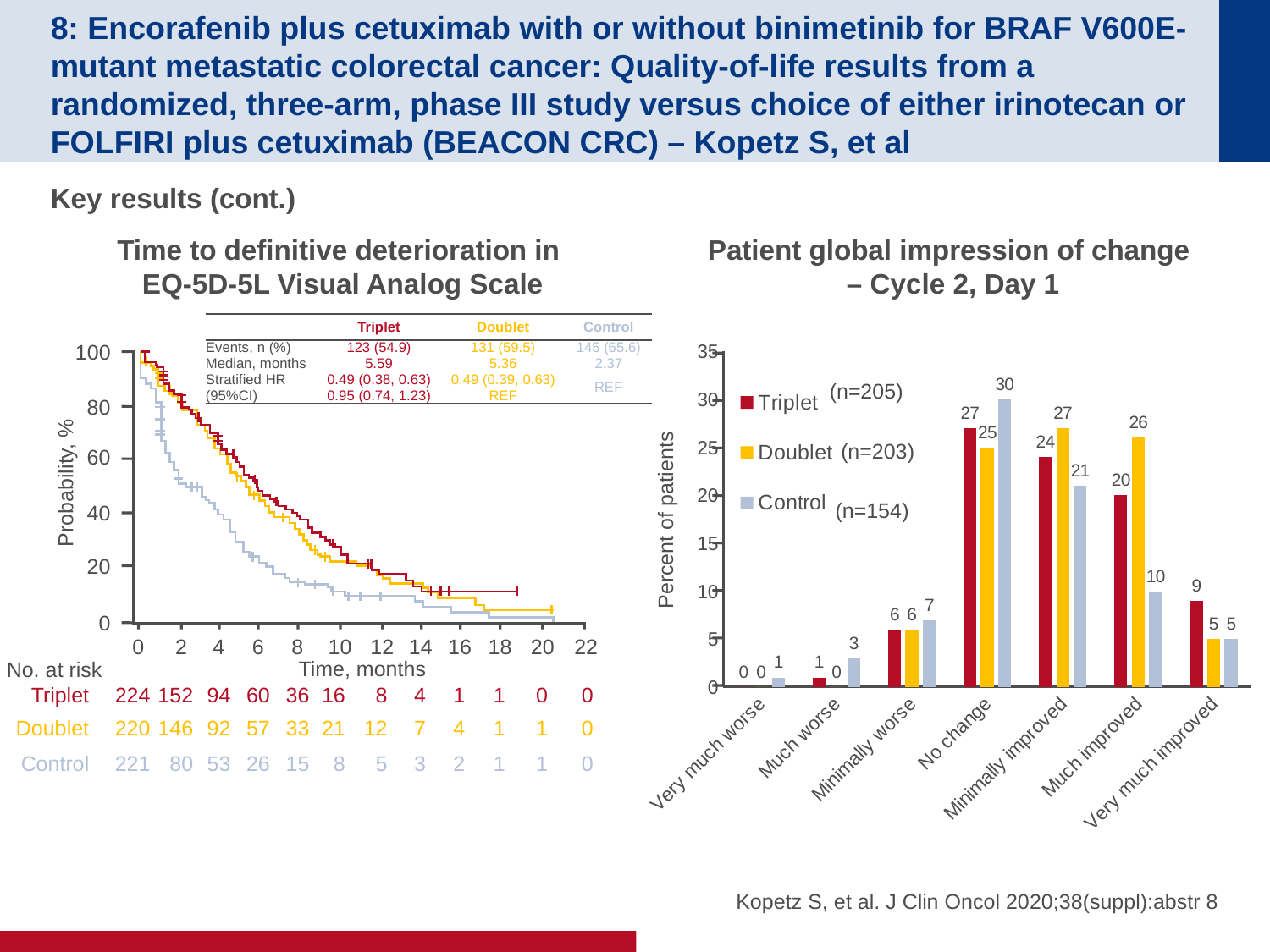
In the 'Patient global impression of change – Cycle 2, Day 1' chart, what is the difference between the Doublet and Control values in the 'Much improved' category? 16 What kind of chart is the 'Patient global impression of change – Cycle 2, Day 1' chart? Bar chart In the 'Patient global impression of change – Cycle 2, Day 1' chart, what percent of Control patients reported 'No change'? 30 In the 'Patient global impression of change – Cycle 2, Day 1' chart, how many series does the legend list? 3 In the 'Patient global impression of change – Cycle 2, Day 1' chart, what is the value for Triplet in the 'Very much improved' category? 9 In the 'Patient global impression of change – Cycle 2, Day 1' chart, which category has the lowest value for the Control series? Very much worse In the 'Patient global impression of change – Cycle 2, Day 1' chart, which category has the highest value for the Triplet series? No change In the 'Patient global impression of change – Cycle 2, Day 1' chart, which is larger in the 'Minimally improved' category: Triplet or Doublet? Doublet In the 'Patient global impression of change – Cycle 2, Day 1' chart, what is the value for Doublet in the 'Much improved' category? 26 In the 'Patient global impression of change – Cycle 2, Day 1' chart, what is the sample size (n) shown for the Doublet group in the legend? n=203 In the 'Patient global impression of change – Cycle 2, Day 1' chart, how many categories are shown on the x axis? 7 In the 'Time to definitive deterioration in EQ-5D-5L Visual Analog Scale' chart, what is the median in months for the Triplet arm? 5.59